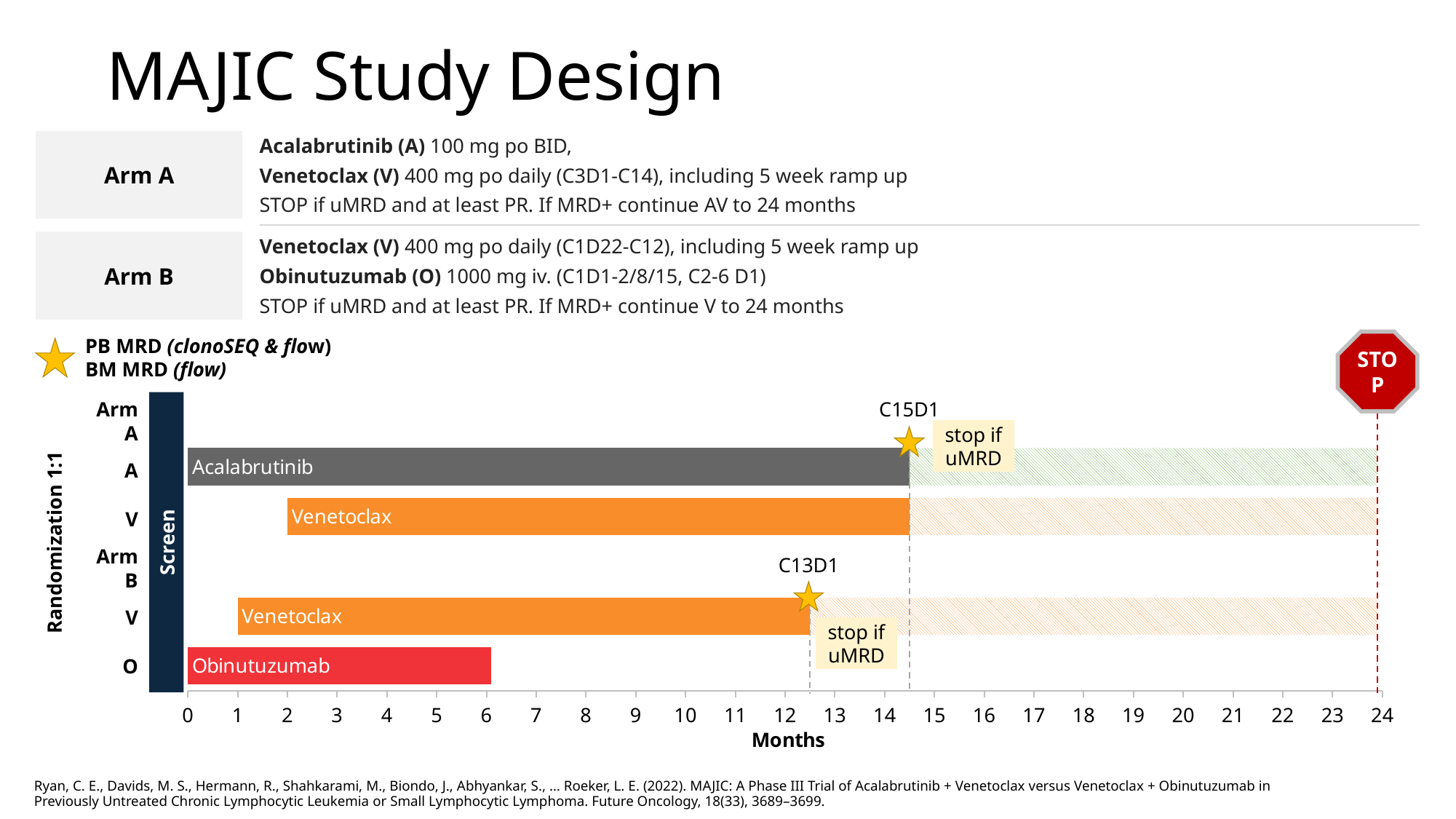
At what month does the Venetoclax bar for Arm B begin? 1 Which drug bar is the shortest on the timeline? Obinutuzumab Is the end of the Arm B Venetoclax bar greater or less than 13 months? less Which drug bar is the longest on the timeline? Acalabrutinib At what month does the Acalabrutinib bar begin? 0 What label is shown above the star marking the Arm B MRD assessment? C13D1 What kind of chart is shown on the slide? bar chart Does the Obinutuzumab bar end before or after month 12? before Is the end of the Acalabrutinib bar greater or less than 14 months? greater What is the label of the x axis of the timeline chart? Months At what month does the Venetoclax bar for Arm A begin? 2 How many solid drug bars are plotted on the timeline? 4